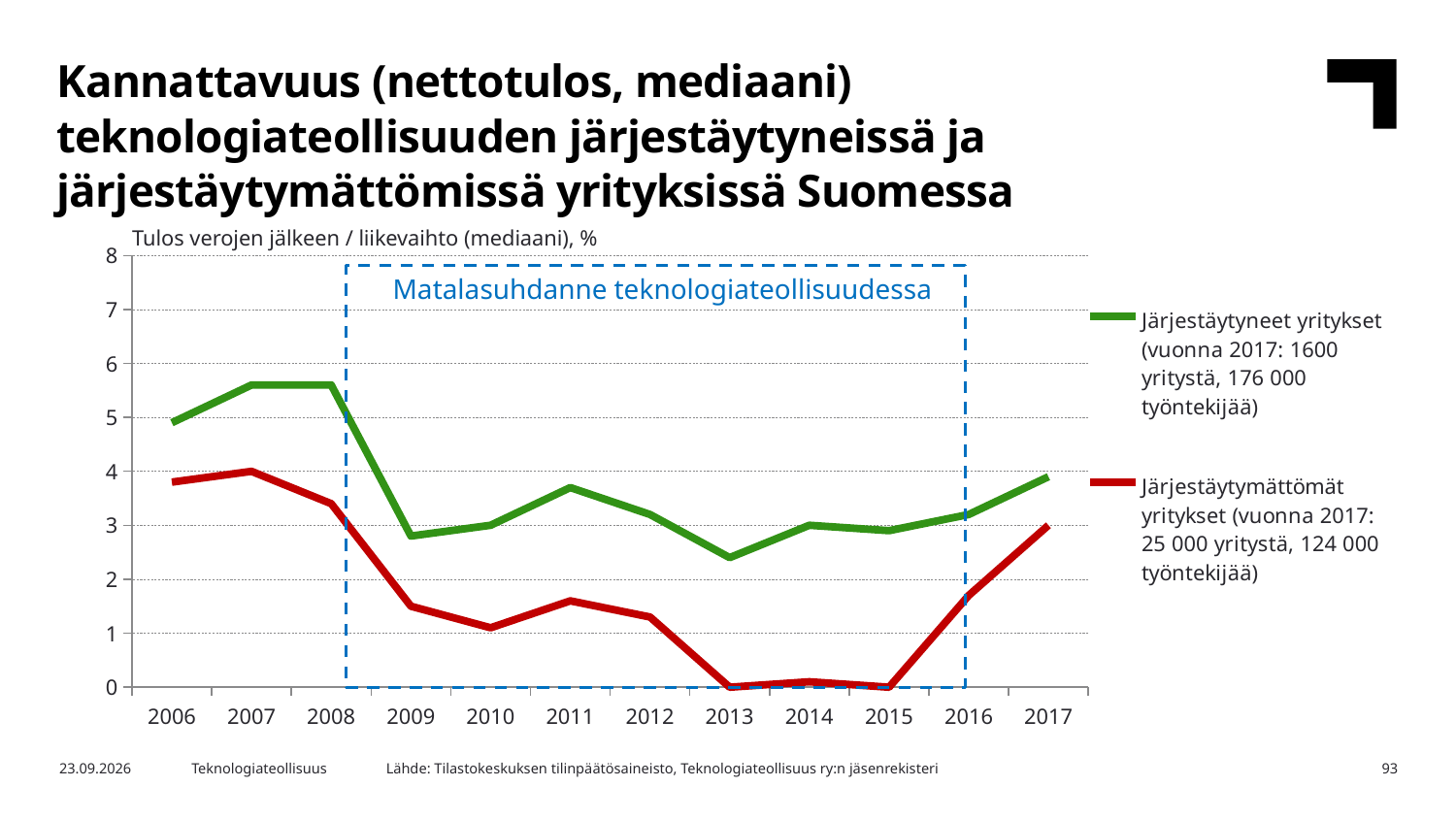
Does the Järjestäytyneet yritykset series rise or fall from 2015 to 2017? rise Is the value for Järjestäytymättömät yritykset in 2010 greater or less than 2? less Is the value for Järjestäytyneet yritykset in 2007 greater or less than 5? greater Is the value for Järjestäytyneet yritykset in 2013 greater or less than 3? less In which year does the Järjestäytyneet yritykset series reach its lowest value? 2013 What label is written inside the dashed box on the chart? Matalasuhdanne teknologiateollisuudessa How many years are plotted along the x axis? 12 How many series does the legend list? 2 Which series has the higher value in 2009, Järjestäytyneet yritykset or Järjestäytymättömät yritykset? Järjestäytyneet yritykset Does the Järjestäytymättömät yritykset series rise or fall from 2008 to 2010? fall What type of chart is shown on the slide? line chart